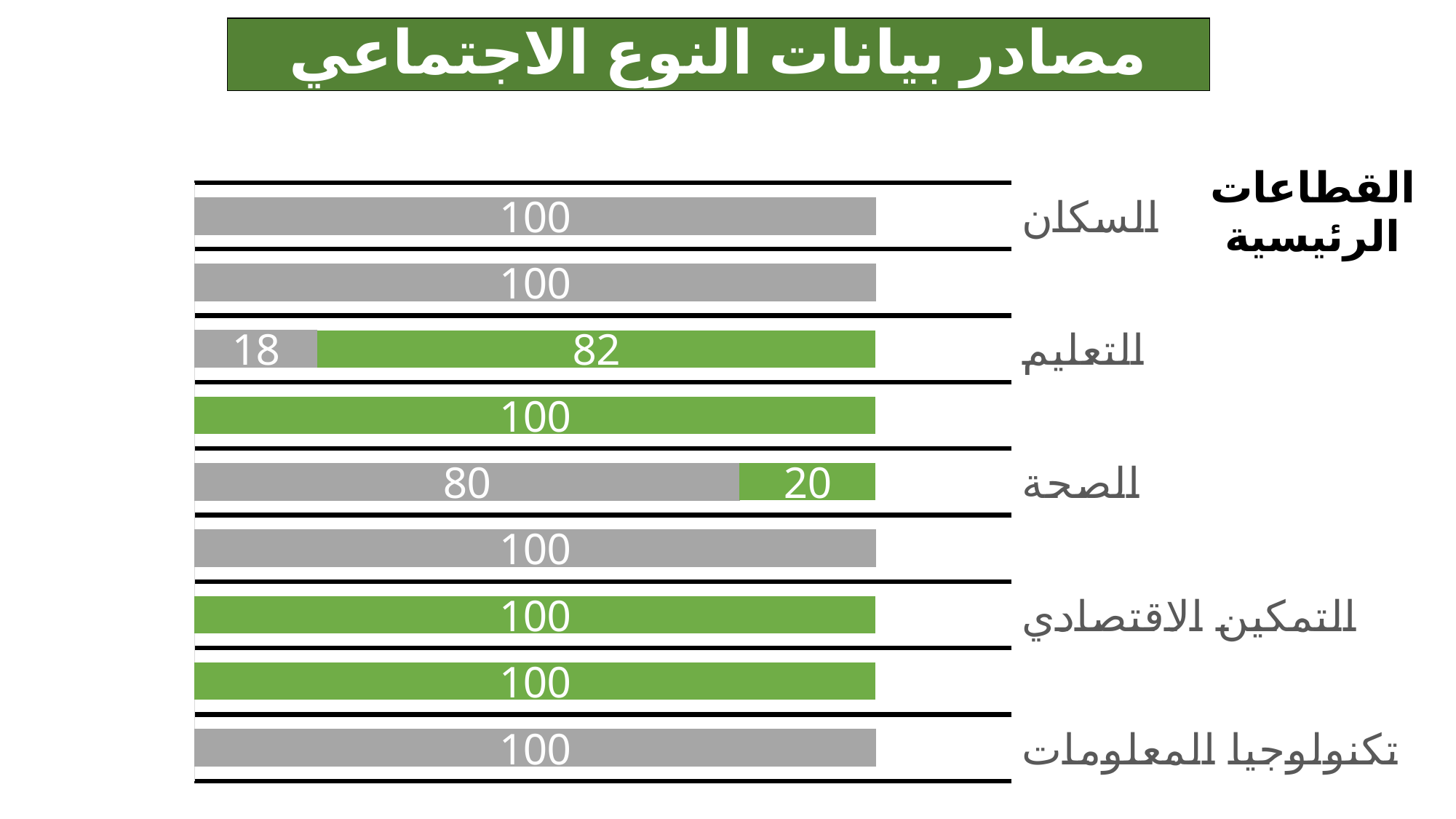
Which is larger: the gray segment of التعليم or the gray segment of الصحة? الصحة How many bars are plotted in the chart? 9 What kind of chart is shown on the slide? Stacked bar chart What is the difference between the green segment of التعليم (82) and the green segment of الصحة (20)? 62 What is the value of the green segment in the bar labelled التعليم? 82 What is the value shown on the bar labelled تكنولوجيا المعلومات? 100 What is the value of the gray segment in the bar labelled الصحة? 80 What is the total of the two segments in the bar labelled التعليم? 100 What is the value of the green segment in the bar labelled الصحة? 20 What colour is the bar labelled التمكين الاقتصادي? Green What is the value of the gray segment in the bar labelled التعليم? 18 What is the title of the chart on the slide? مصادر بيانات النوع الاجتماعي